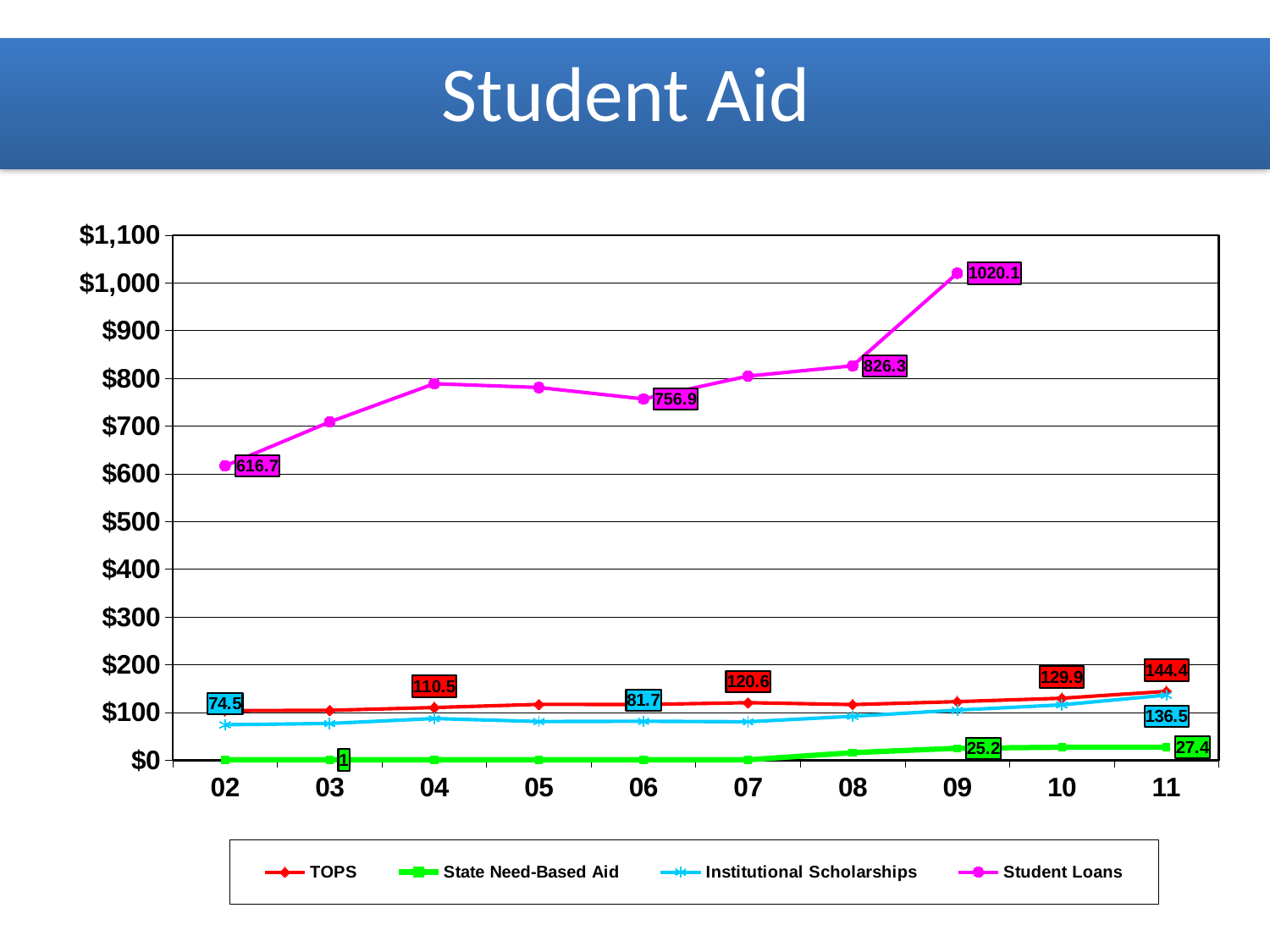
Does State Need-Based Aid rise or fall from 07 to 11? rise Which year has the larger Student Loans value, 06 or 08? 08 What is the value for Student Loans in 09? 1020.1 What is the value for Institutional Scholarships in 02? 74.5 How many years are shown on the x axis? 10 Is the value for Student Loans in 04 greater or less than $700? greater By how much did Student Loans increase from 02 to 09? 403.4 What is the value for State Need-Based Aid in 09? 25.2 What is the difference between TOPS and Institutional Scholarships in 11? 7.9 What kind of chart is shown on the slide? line chart How many series does the legend list? 4 What is the value for TOPS in 11? 144.4